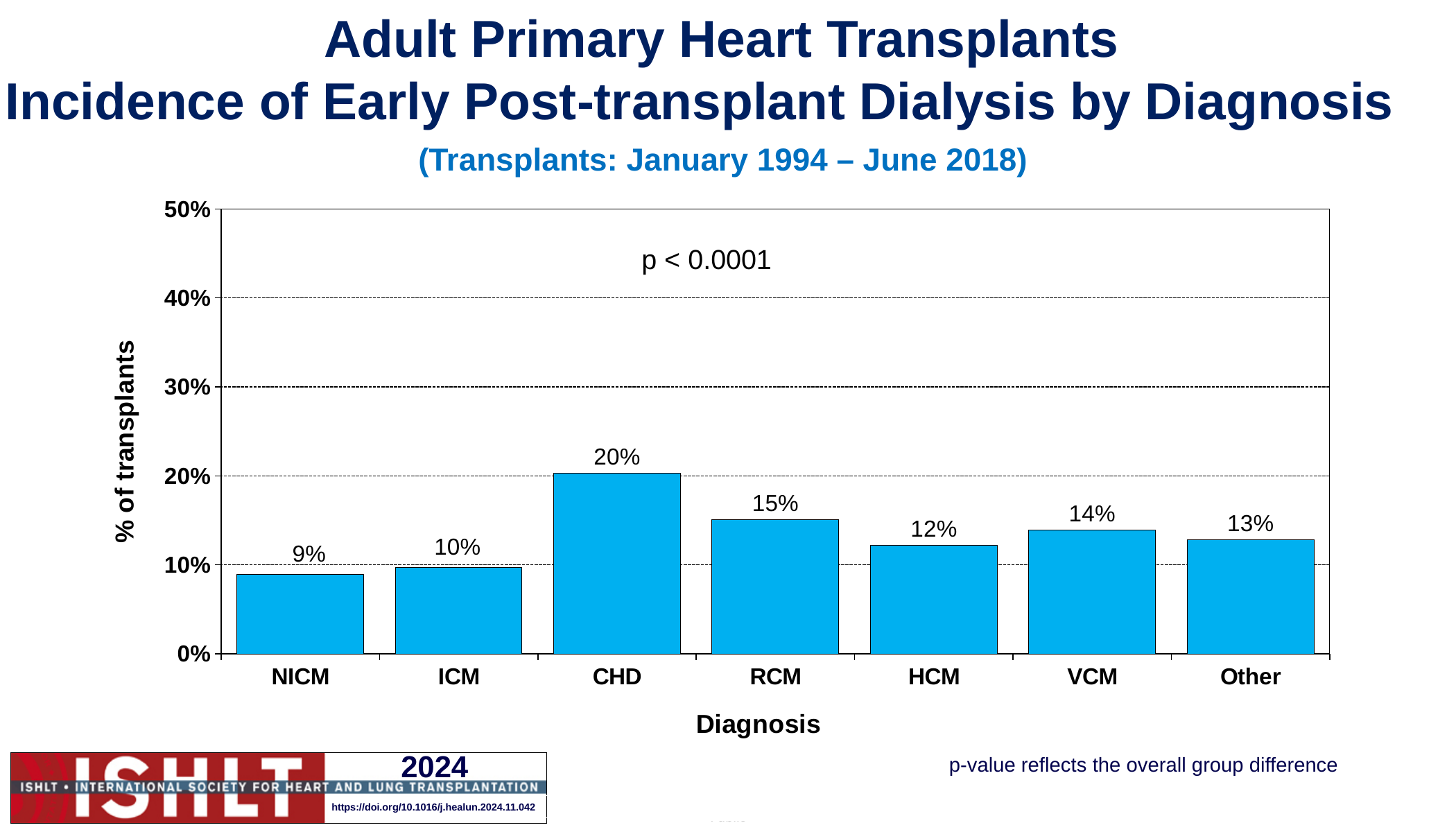
Is the value for CHD greater or less than 30%? less What is the percentage of transplants with early post-transplant dialysis for the CHD diagnosis? 20% Which diagnosis has the highest incidence of early post-transplant dialysis? CHD Which has a larger value, RCM or Other? RCM Which diagnosis has the lowest incidence of early post-transplant dialysis? NICM What is the value shown for the VCM diagnosis? 14% What is the label of the y axis? % of transplants What is the difference between the values for RCM and HCM? 3% How many diagnosis categories are shown on the x axis? 7 What is the difference between the values for CHD and ICM? 10% What is the value shown for the NICM diagnosis? 9% What kind of chart is shown on the slide? Bar chart